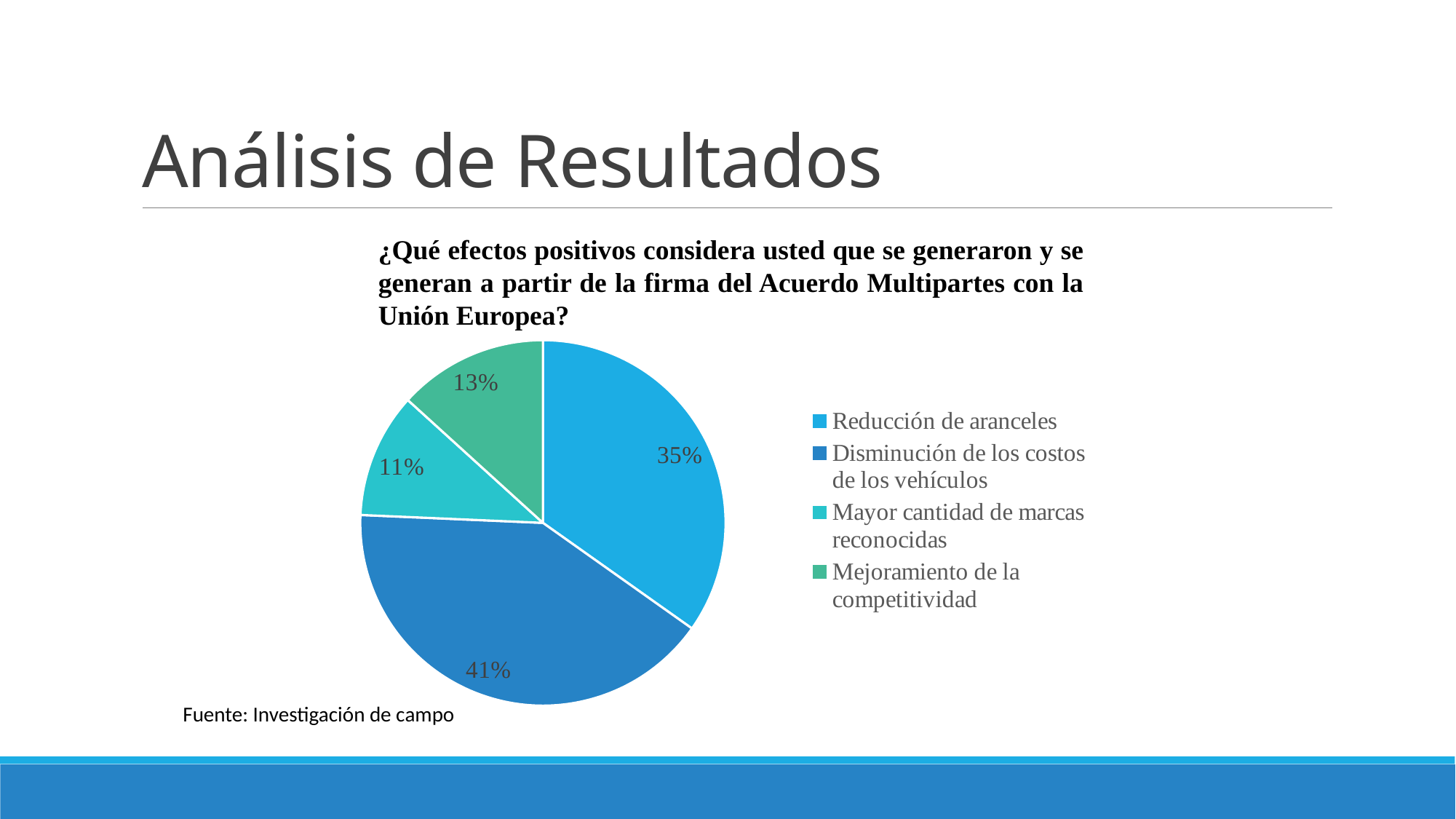
Which category has the smallest share of the pie? Mayor cantidad de marcas reconocidas What kind of chart is shown on the slide? Pie chart Which category has the largest share of the pie? Disminución de los costos de los vehículos What percentage of the pie corresponds to Reducción de aranceles? 35% What percentage of the pie corresponds to Mayor cantidad de marcas reconocidas? 11% What is the difference in percentage points between Disminución de los costos de los vehículos and Reducción de aranceles? 6 What percentage of the pie corresponds to Mejoramiento de la competitividad? 13% What percentage of the pie corresponds to Disminución de los costos de los vehículos? 41% How many categories does the pie chart have? 4 What is the source cited below the chart? Investigación de campo Which is larger: the share for Mejoramiento de la competitividad or the share for Mayor cantidad de marcas reconocidas? Mejoramiento de la competitividad What is the combined share of Reducción de aranceles and Disminución de los costos de los vehículos? 76%